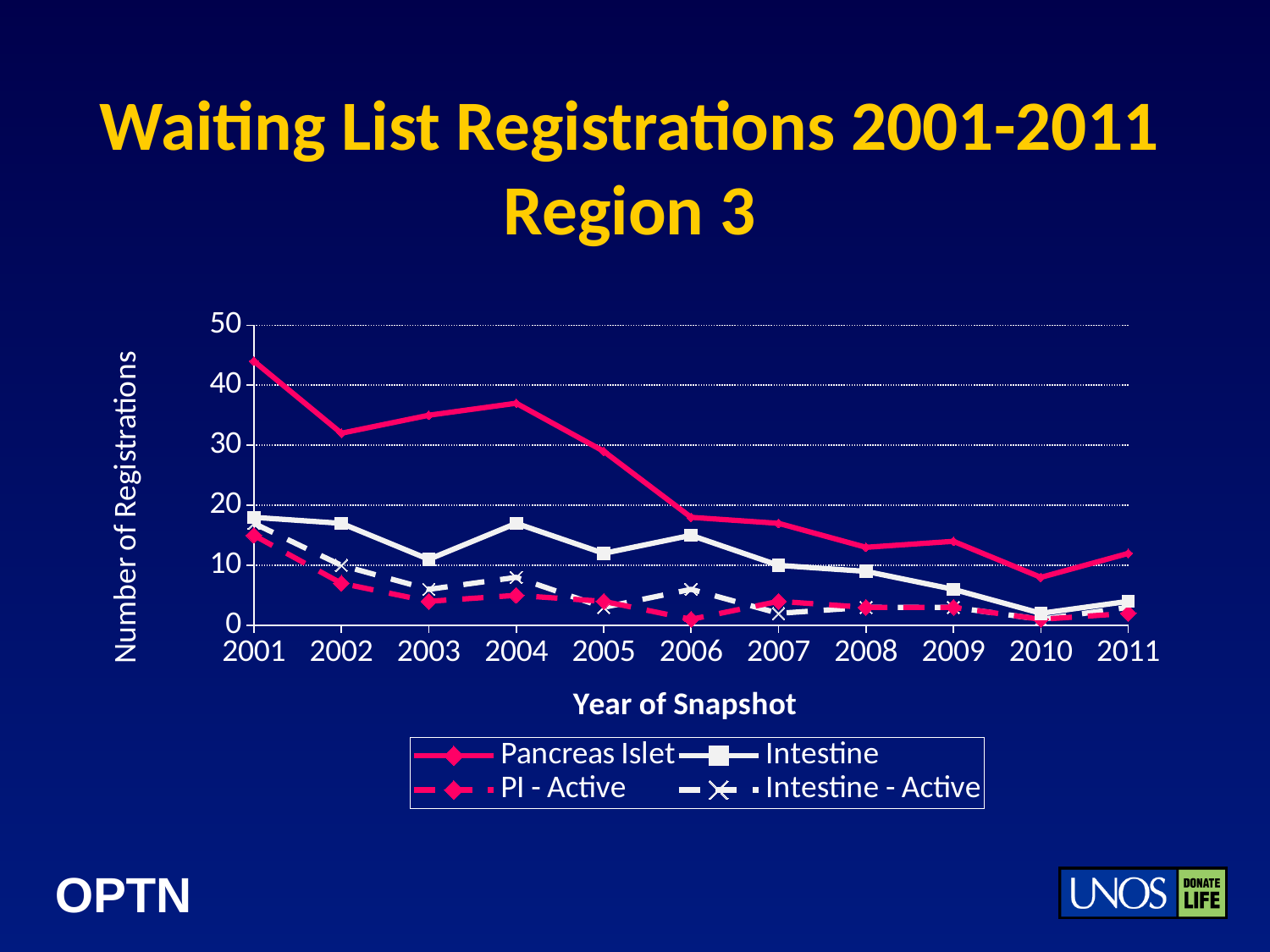
In which year is the Pancreas Islet series at its lowest? 2010 In 2005, which is larger: Pancreas Islet or Intestine? Pancreas Islet What is the label of the y axis? Number of Registrations Is the value for Pancreas Islet in 2005 greater or less than 20? greater Is the value for Intestine in 2010 greater or less than 10? less Is the value for Pancreas Islet in 2006 greater or less than 20? less Does the Pancreas Islet series generally rise or fall from 2001 to 2011? fall What kind of chart is shown on the slide? line chart How many years are plotted along the x axis? 11 In which year is the Pancreas Islet series at its highest? 2001 How many series does the legend list? 4